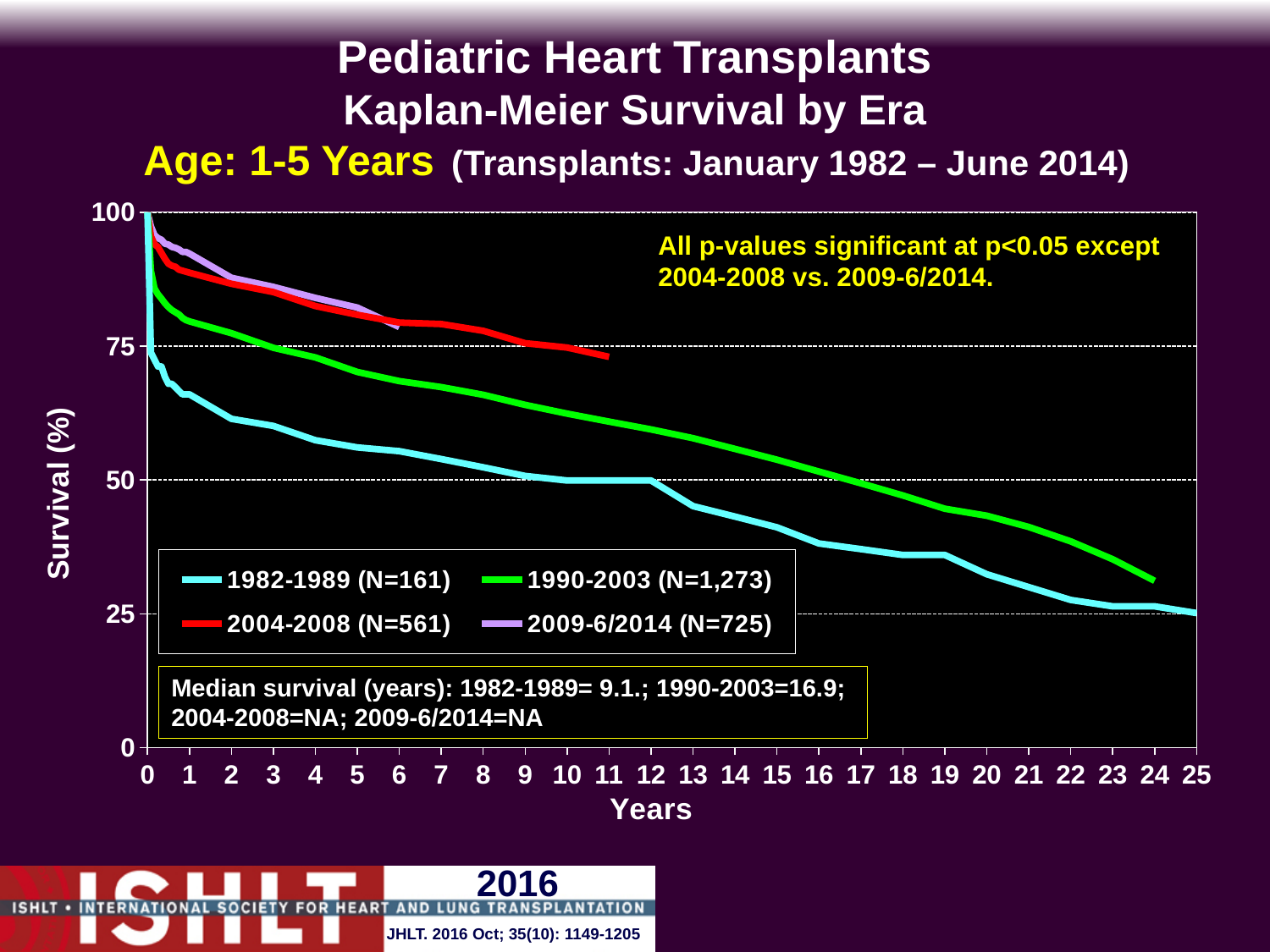
Is the survival value for the 1982-1989 era at 25 years greater or less than 50? less How many series does the legend list? 4 What kind of chart is shown on the slide? line chart What is the median survival in years for the 1982-1989 era? 9.1 Which era has the lowest survival curve across the chart? 1982-1989 According to the legend, what is N for the 1990-2003 era? 1,273 What is the label of the y axis? Survival (%) According to the legend, what is N for the 2009-6/2014 era? 725 Is the survival value for the 2004-2008 era at 5 years greater or less than 75? greater At 5 years, which era has higher survival: 1990-2003 or 1982-1989? 1990-2003 Do the survival curves rise or fall as years increase? fall Is the survival value for the 1990-2003 era at 10 years greater or less than 50? greater